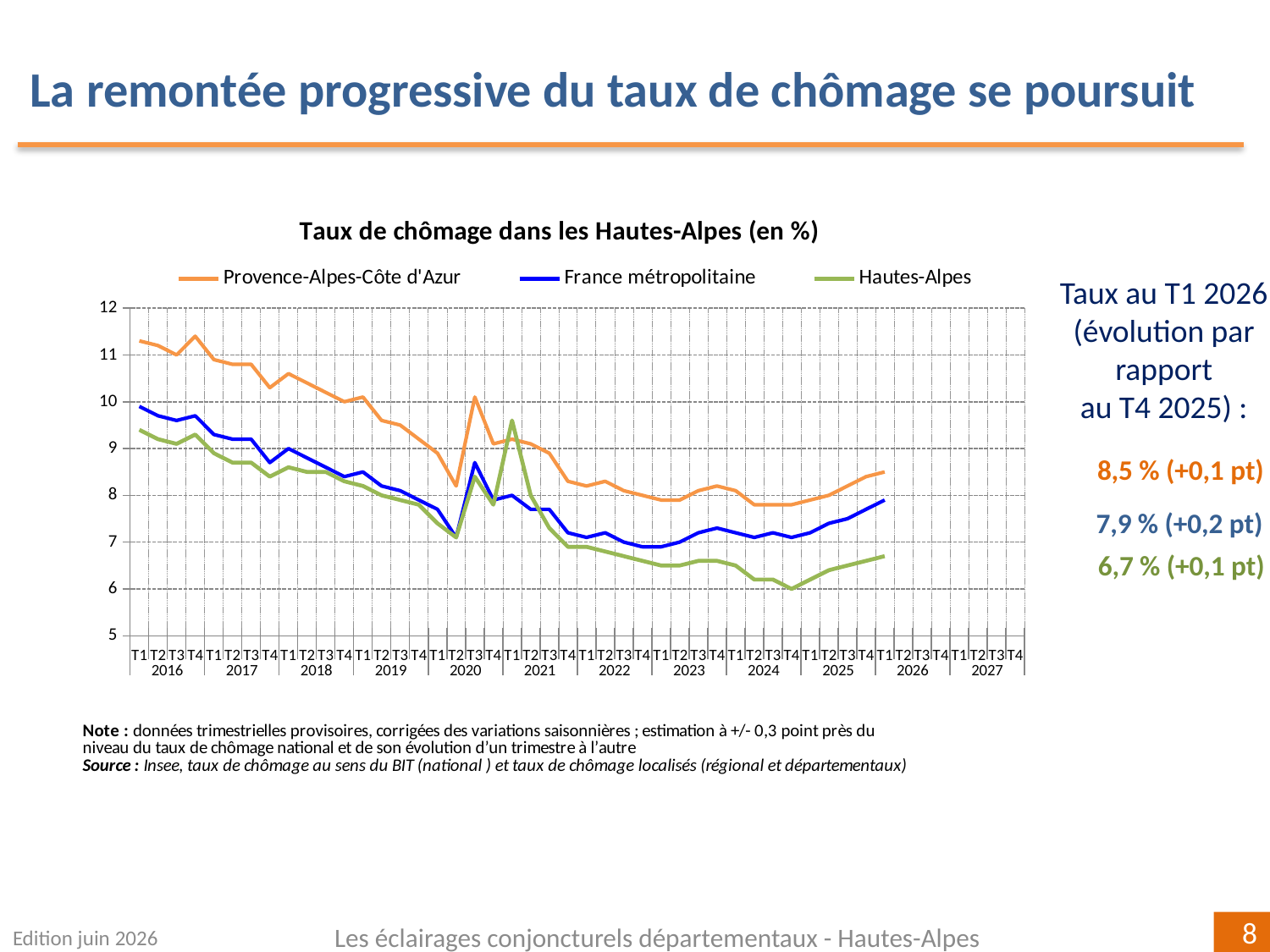
Which series has the lowest value at T1 2026? Hautes-Alpes How many series does the legend list? 3 Does the Hautes-Alpes series rise or fall overall between T1 2016 and T4 2024? Fall What is the difference between the Provence-Alpes-Côte d'Azur rate and the Hautes-Alpes rate at T1 2026? 1,8 pt What is the unemployment rate for Provence-Alpes-Côte d'Azur at T1 2026? 8,5 % Is the value for Hautes-Alpes at T4 2024 greater or less than 7? less What is the unemployment rate for France métropolitaine at T1 2026? 7,9 % What is the unemployment rate for Hautes-Alpes at T1 2026? 6,7 % At T1 2026, which is larger: the rate for France métropolitaine or the rate for Hautes-Alpes? France métropolitaine What kind of chart is shown on the slide? Line chart Which series has the highest value at T1 2026? Provence-Alpes-Côte d'Azur Is the value for Provence-Alpes-Côte d'Azur at T1 2016 greater or less than 11? greater